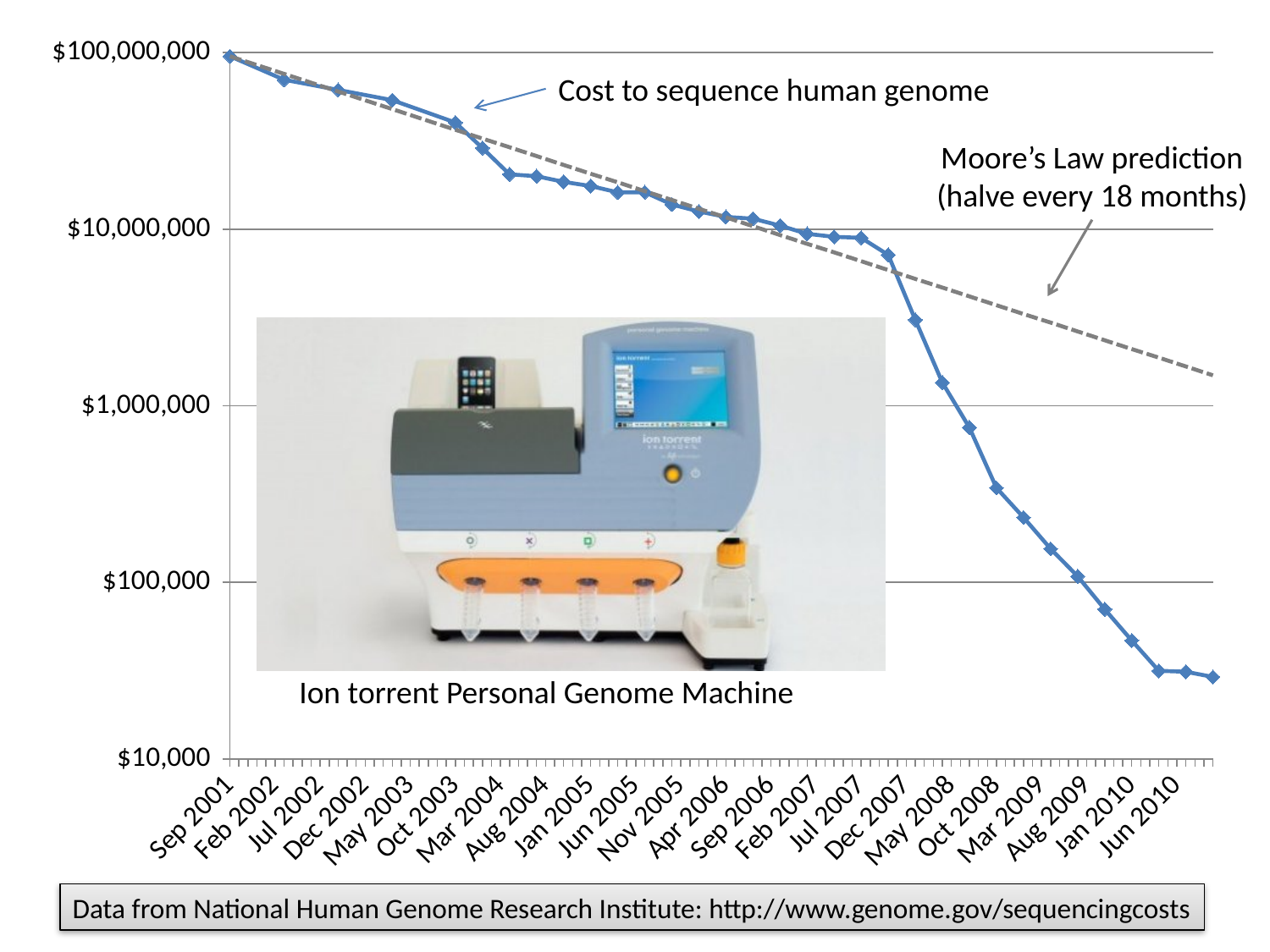
What kind of chart is shown on the slide? line chart Is the cost to sequence a human genome around Jun 2010 greater or less than $100,000? less At the right end of the chart, which is higher: the actual cost to sequence a human genome or the Moore's Law prediction? Moore's Law prediction Is the cost to sequence a human genome around Mar 2004 greater or less than $10,000,000? greater How many data series are plotted on the chart? 2 What does the dashed grey line represent? Moore's Law prediction (halve every 18 months) Is the cost to sequence a human genome around Oct 2008 greater or less than $1,000,000? less What does the solid blue line with markers represent? Cost to sequence human genome At which x-axis date is the cost to sequence a human genome highest? Sep 2001 Does the cost to sequence a human genome rise or fall from Sep 2001 to Jun 2010? fall